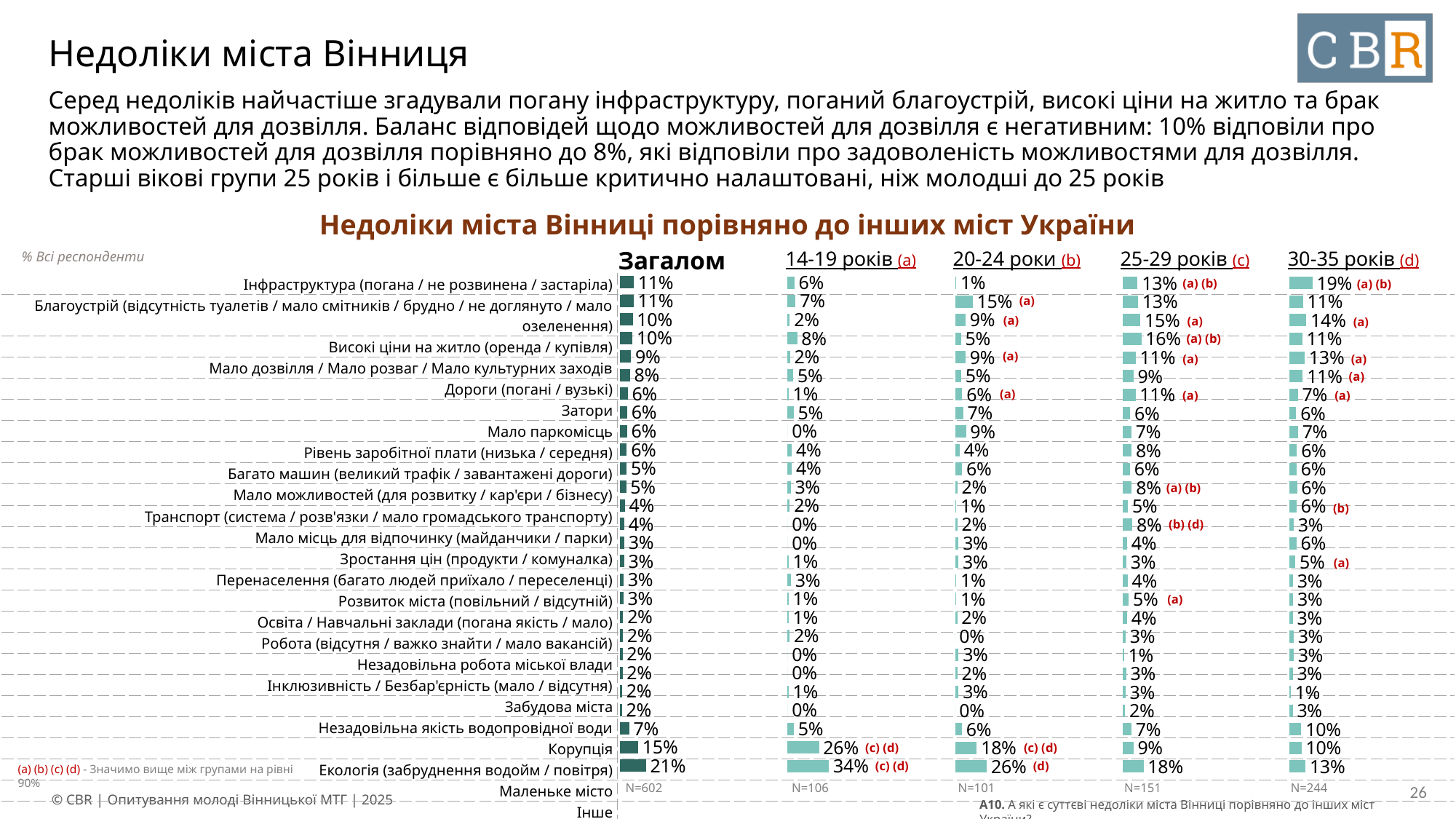
For Інфраструктура (погана / не розвинена / застаріла), which is larger: the 25-29 років value or the 14-19 років value? 25-29 років What is the value for Інфраструктура (погана / не розвинена / застаріла) in the 20-24 роки column? 1% What kind of chart is used on the slide to show the shortcomings of Vinnytsia? Bar chart What is the difference between the 30-35 років and 14-19 років values for Інфраструктура (погана / не розвинена / застаріла)? 13 percentage points What is the value for Інфраструктура (погана / не розвинена / застаріла) in the 30-35 років column? 19% Which age group has the highest value for Інфраструктура (погана / не розвинена / застаріла)? 30-35 років What is the value for Інфраструктура (погана / не розвинена / застаріла) in the 14-19 років column? 6% What is the highest value shown in the Загалом column? 21% What is the value for Інфраструктура (погана / не розвинена / застаріла) in the Загалом column? 11% What is the title of the chart on the slide? Недоліки міста Вінниці порівняно до інших міст України What is the highest value shown in the 14-19 років column? 34% How many age-group columns are shown in addition to Загалом? 4